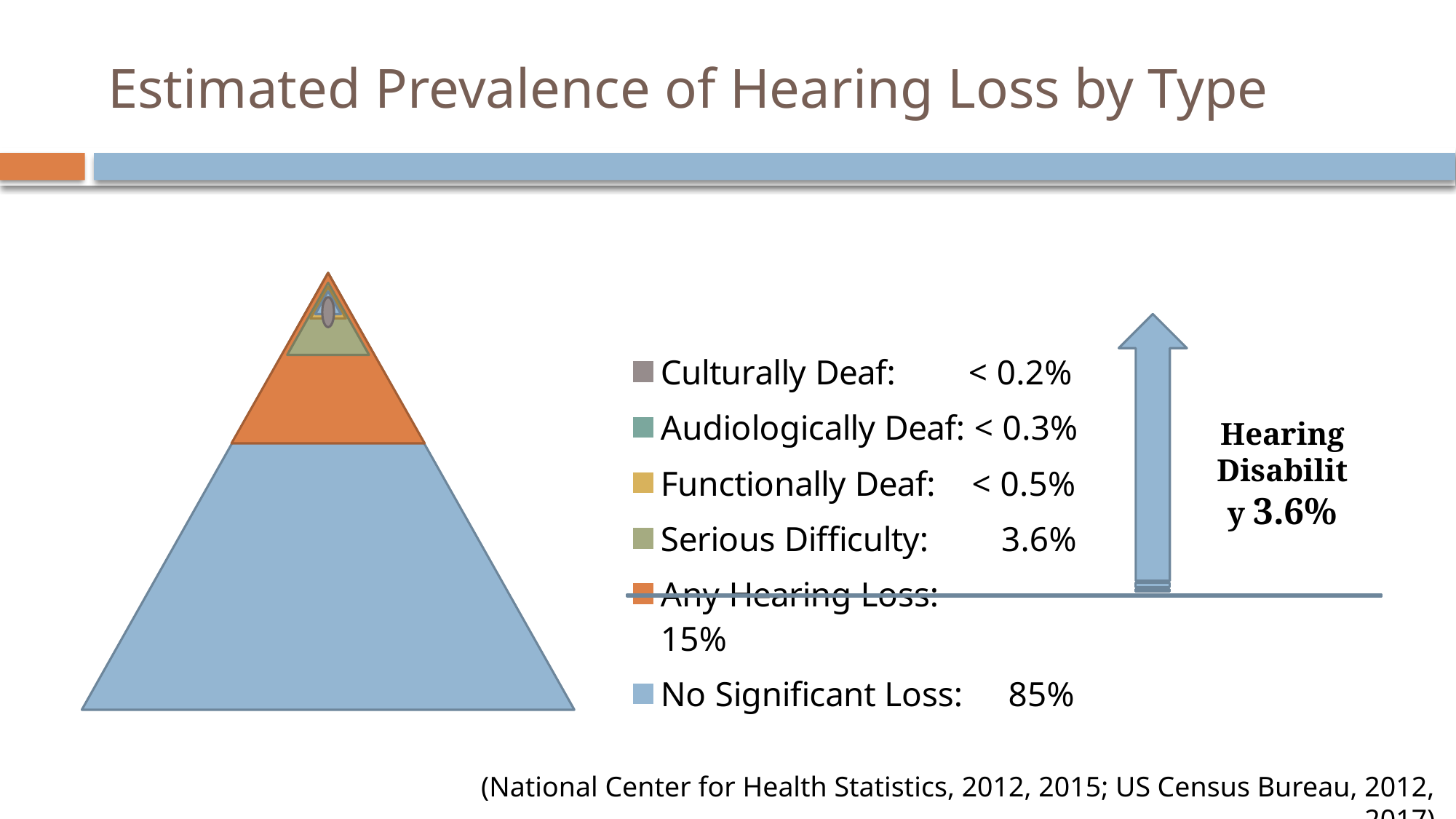
What kind of chart is shown on the slide? Pyramid chart What is the value shown for No Significant Loss? 85% How many categories does the legend list? 6 Which category has the lowest value? Culturally Deaf What is the difference between the values for No Significant Loss and Any Hearing Loss? 70% What is the title of the chart? Estimated Prevalence of Hearing Loss by Type What is the value shown for Serious Difficulty? 3.6% What is the value shown for Functionally Deaf? < 0.5% What is the value shown for Any Hearing Loss? 15% Which is larger, the value for Any Hearing Loss or the value for Serious Difficulty? Any Hearing Loss Which category has the highest value? No Significant Loss What is the value shown for Culturally Deaf? < 0.2%